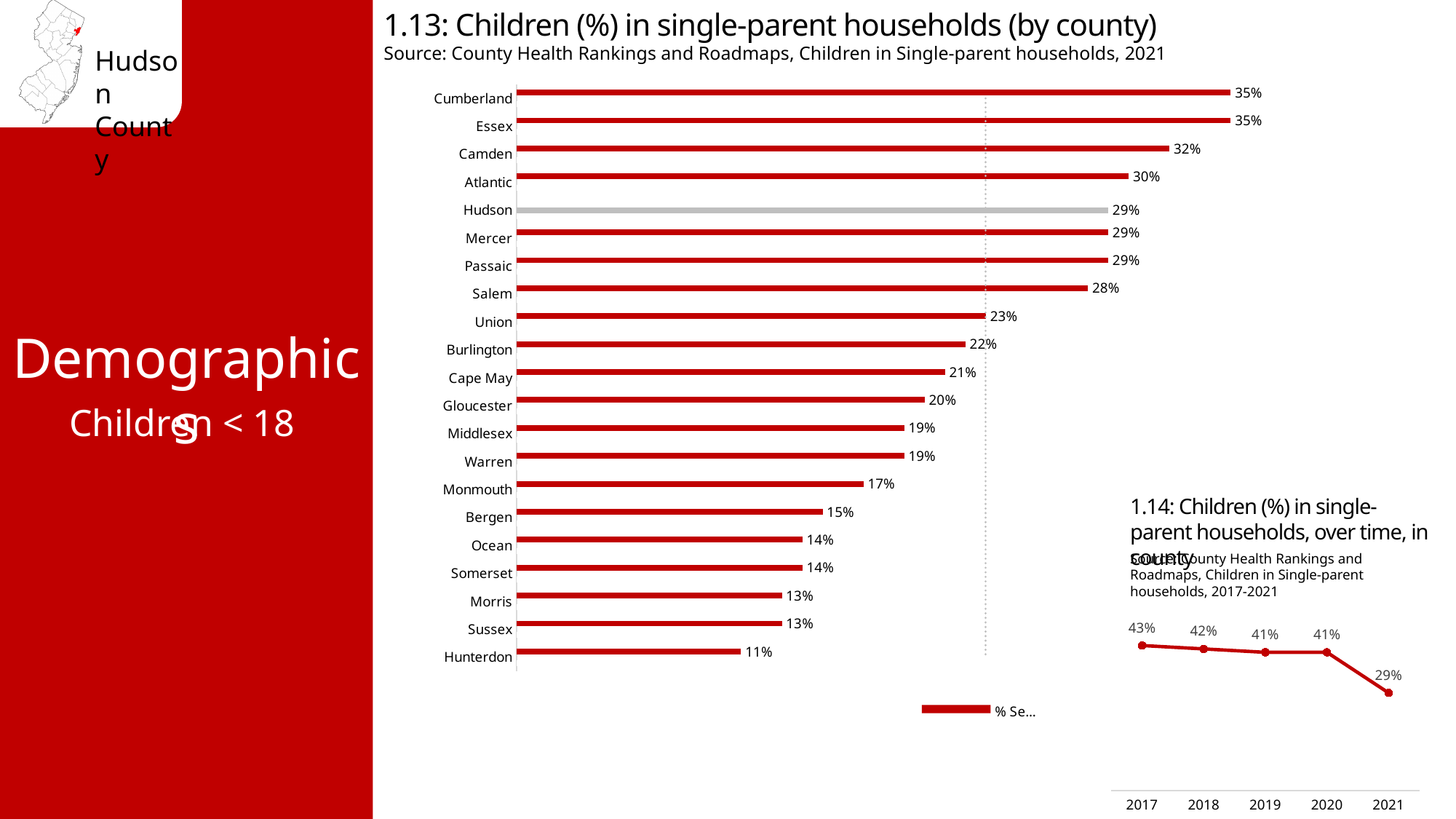
In chart 1.13, which county's bar is coloured grey instead of red? Hudson In chart 1.13, which county has the lowest value? Hunterdon In chart 1.13, what is the value for Camden? 32% In chart 1.13 (Children (%) in single-parent households by county), what is the value for Hudson? 29% What kind of chart is chart 1.13? Bar chart In chart 1.14, what is the value for 2021? 29% In chart 1.13, what is the difference between the values for Cumberland and Hunterdon? 24% In chart 1.13, how many counties are shown? 21 In chart 1.14, do the values rise or fall from 2017 to 2021? Fall In chart 1.14 (Children (%) in single-parent households over time), what is the value for 2017? 43% In chart 1.13, which is larger, the value for Atlantic or the value for Salem? Atlantic In chart 1.14, what is the difference between the values for 2020 and 2021? 12%